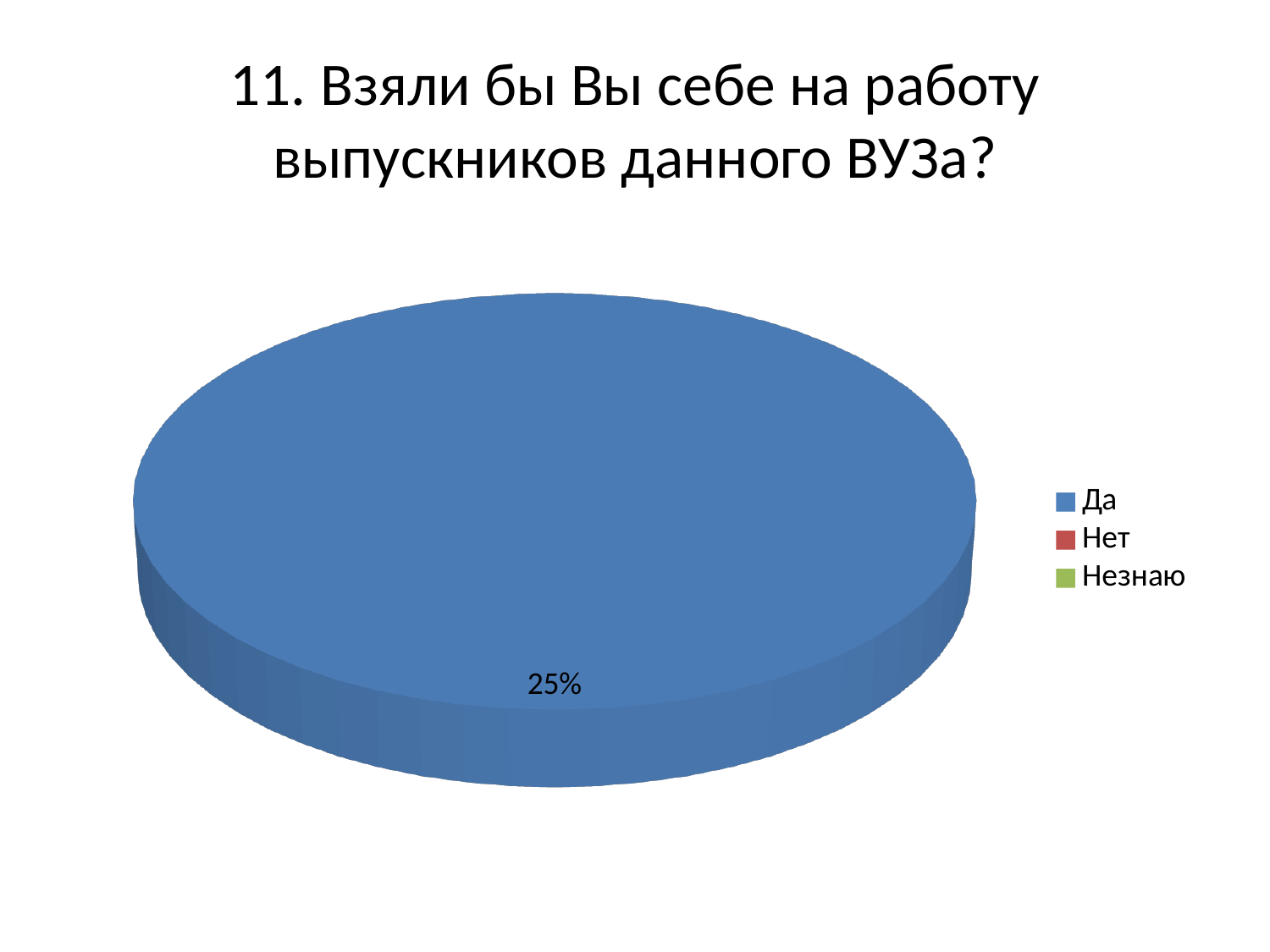
What kind of chart is shown on the slide? pie chart Is the share for Да larger or smaller than the share for Нет? larger What percentage label is printed on the pie? 25% What is the title of the chart? 11. Взяли бы Вы себе на работу выпускников данного ВУЗа? Which category occupies the largest share of the pie? Да Which category is shown in blue in the legend? Да Is the share for Да larger or smaller than the share for Незнаю? larger How many categories does the legend list? 3